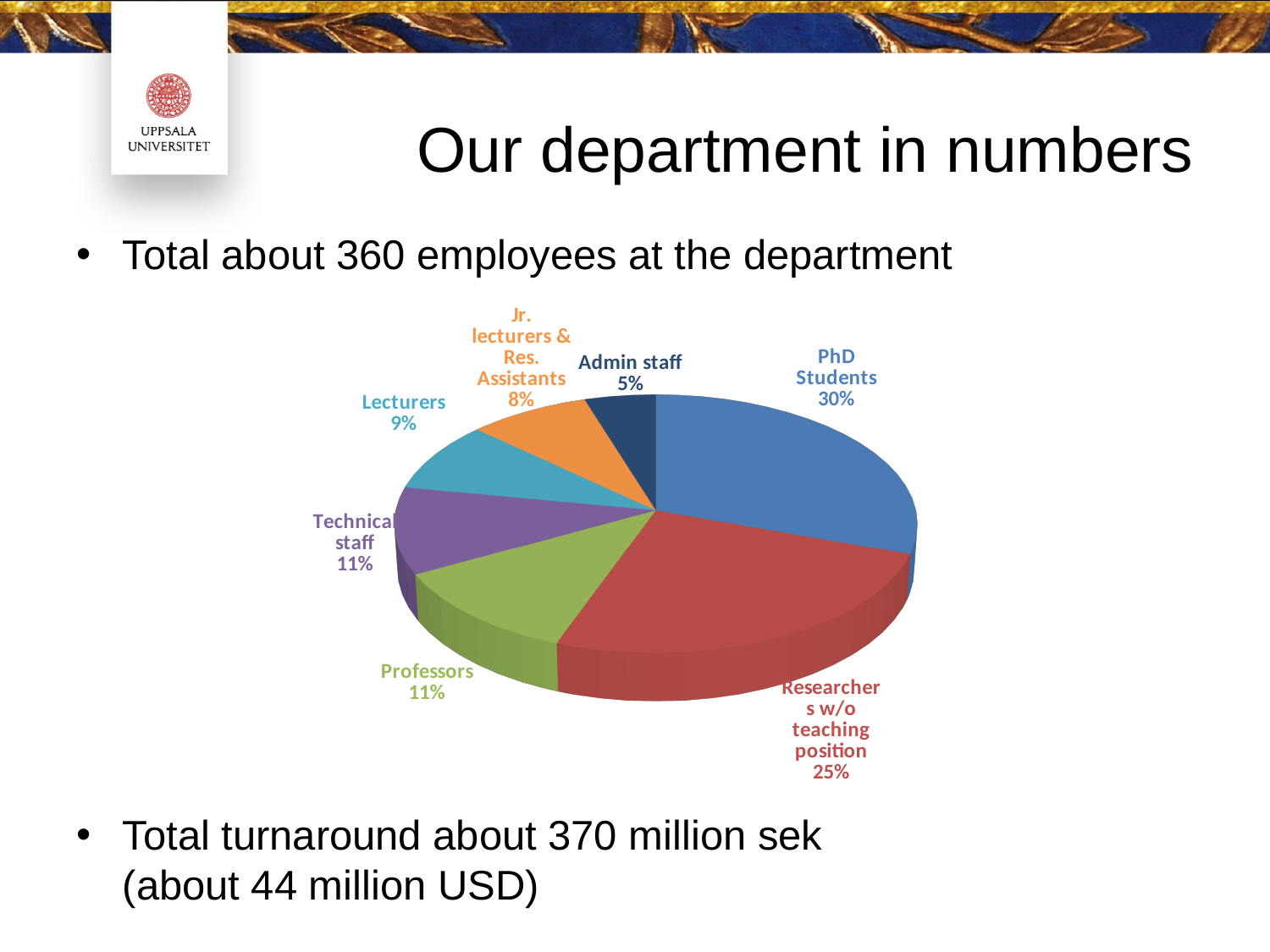
What kind of chart is shown on the slide? Pie chart What percentage is shown for Admin staff? 5% What percentage is shown for Researchers w/o teaching position? 25% What share of the pie do PhD Students represent? 30% What percentage is shown for Jr. lecturers & Res. Assistants? 8% What colour is the slice for Professors? Green How many categories are shown in the pie chart? 7 Which is larger, the share for Lecturers or the share for Jr. lecturers & Res. Assistants? Lecturers What percentage is shown for Lecturers? 9% Which category has the smallest slice of the pie? Admin staff Which category has the largest slice of the pie? PhD Students What is the difference in percentage points between PhD Students and Researchers w/o teaching position? 5